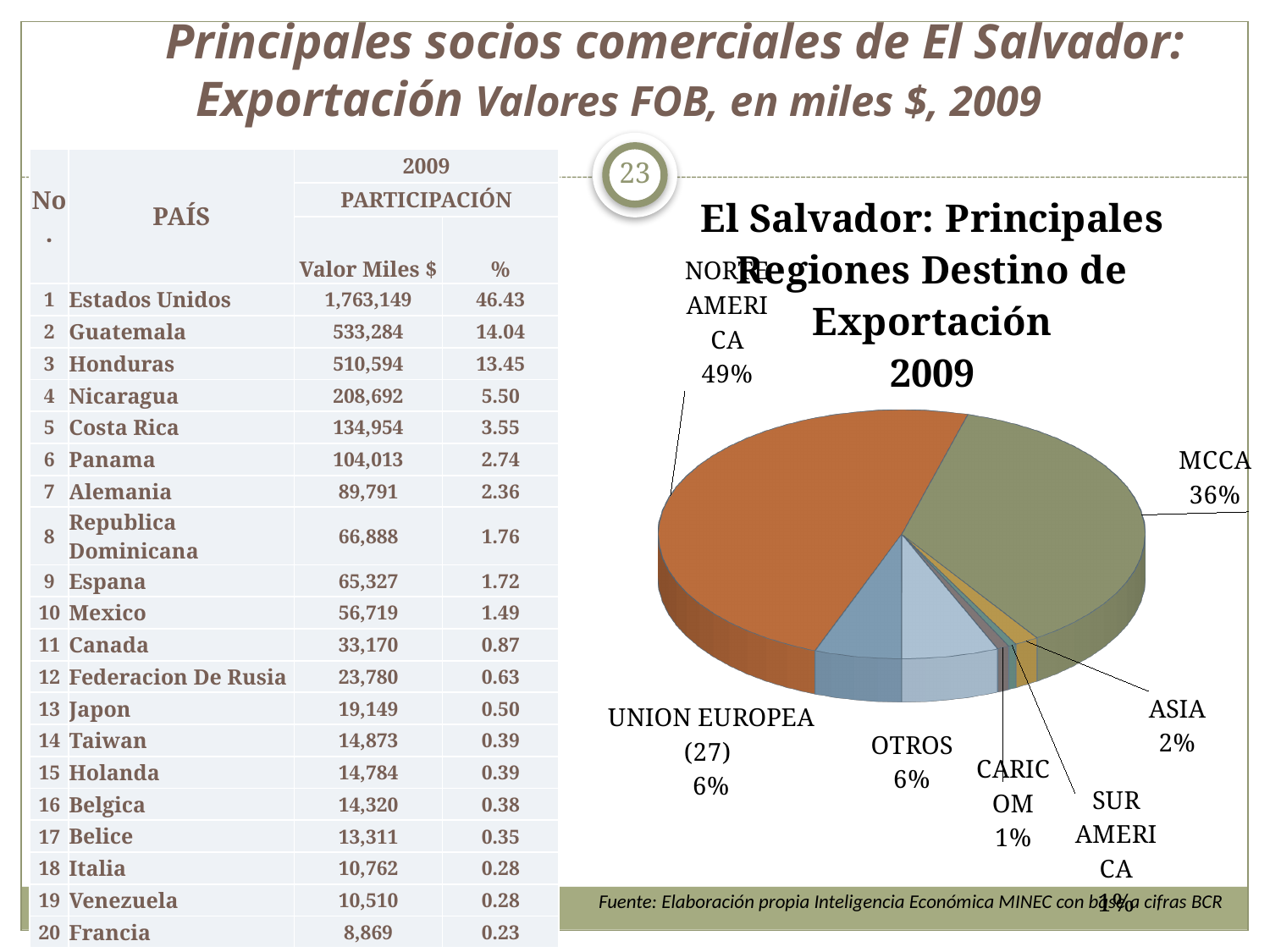
What share of the pie chart does NORTE AMERICA represent? 49% How many slices does the pie chart have? 7 Which slice is larger in the pie chart, MCCA or UNION EUROPEA (27)? MCCA What percentage is shown for MCCA in the pie chart? 36% What type of chart is shown on the right side of the slide? Pie chart What percentage is shown for CARICOM in the pie chart? 1% What percentage is shown for ASIA in the pie chart? 2% What percentage is shown for UNION EUROPEA (27) in the pie chart? 6% What percentage is shown for OTROS in the pie chart? 6% Which region has the largest slice in the pie chart? NORTE AMERICA By how many percentage points does NORTE AMERICA exceed MCCA in the pie chart? 13 What is the title of the pie chart? El Salvador: Principales Regiones Destino de Exportación 2009